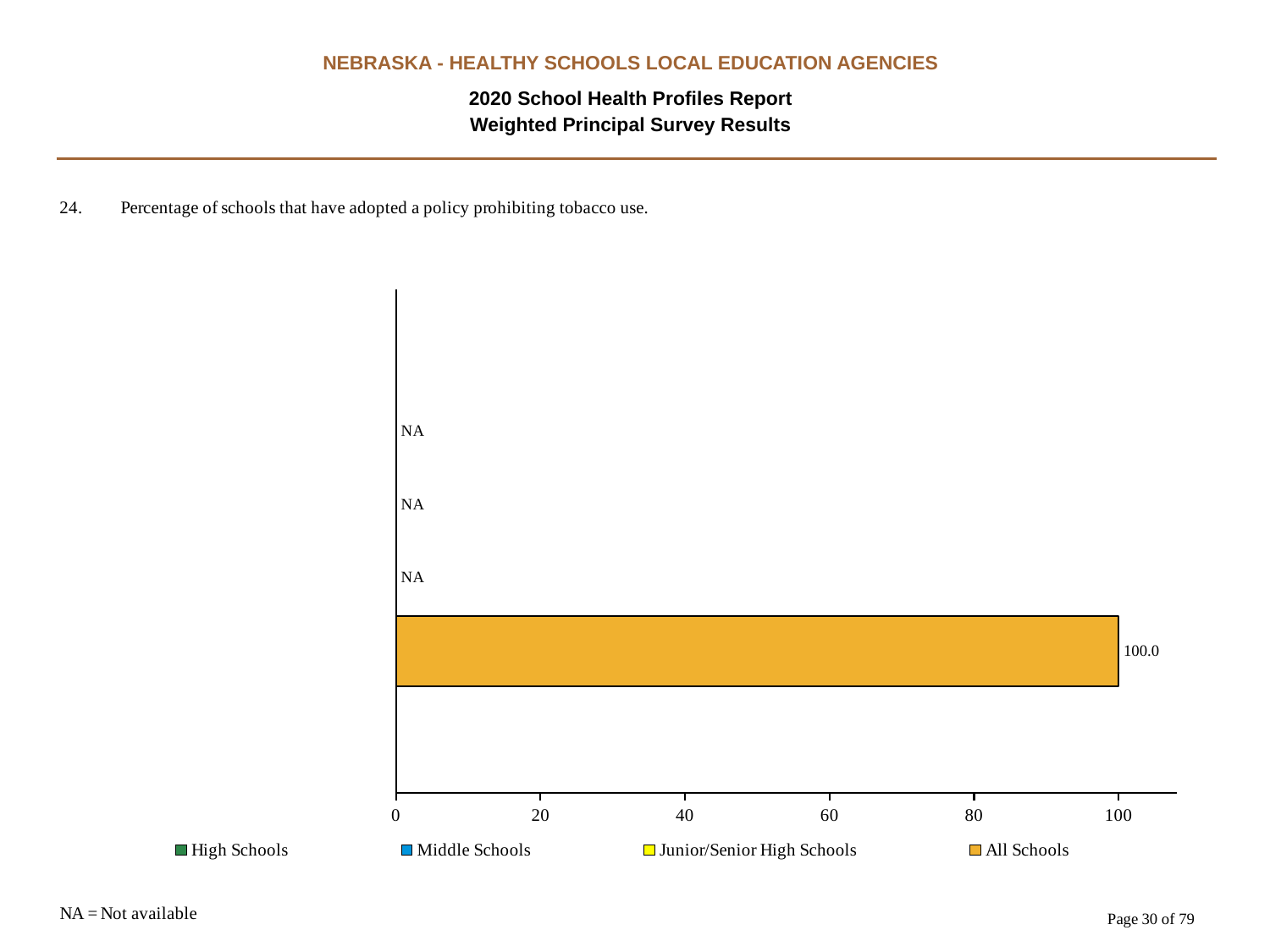
How many series does the legend list? 4 Which series has a plotted bar with a value? All Schools What is shown for Junior/Senior High Schools? NA What does NA stand for according to the slide? Not available What is the value for All Schools? 100.0 What is the highest tick value shown on the x axis? 100 What kind of chart is this? bar chart Is the value for All Schools greater or less than 80? greater What is shown for High Schools? NA How many series are marked NA? 3 What is shown for Middle Schools? NA